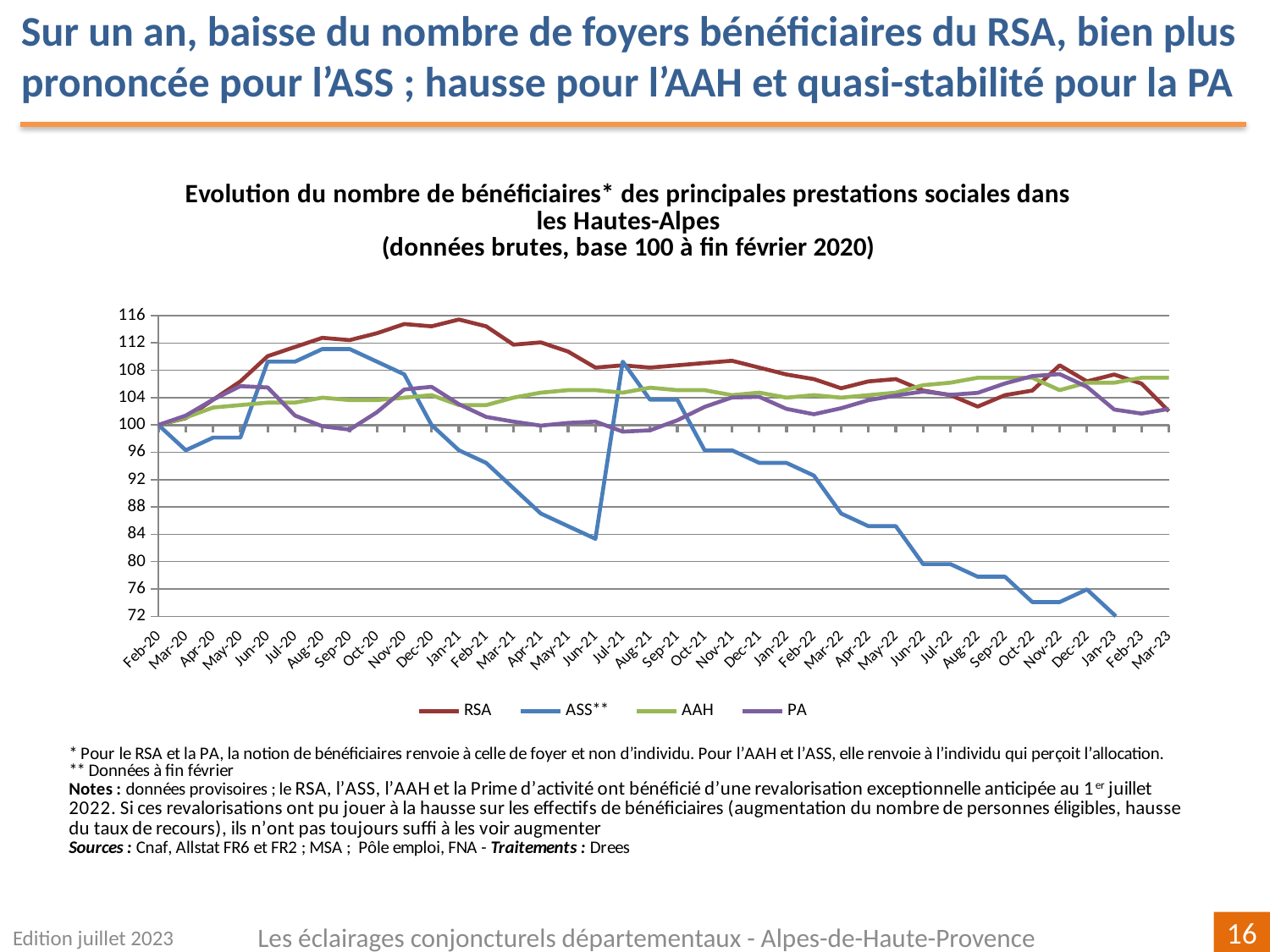
What is the value of all four series at Feb-20? 100 At Mar-22, which is larger, the value for RSA or the value for ASS**? RSA What kind of chart is shown on the slide? line chart Does the ASS** series rise or fall between Jul-21 and Mar-23? fall Is the value for AAH at Mar-23 greater or less than 104? greater Is the value for RSA at Jan-21 greater or less than 112? greater How many series does the legend list? 4 Is the value for ASS** at Sep-22 greater or less than 80? less How many monthly points are plotted along the x axis, from Feb-20 to Mar-23? 38 Which series has the highest value at Jan-21? RSA